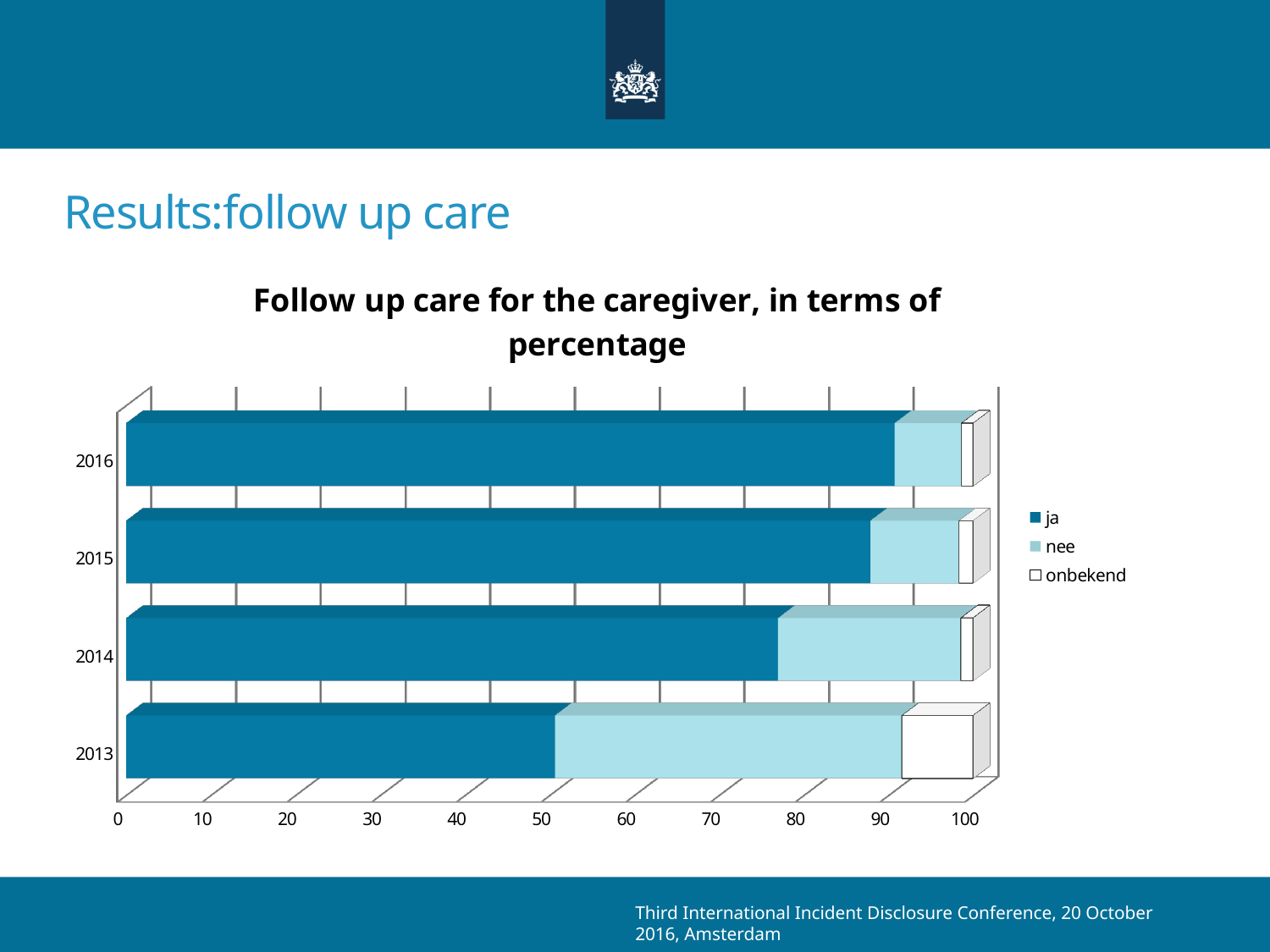
Is the 'ja' value for 2013 greater or less than 60? less How many years are shown on the chart? 4 Which year has the largest 'ja' segment? 2016 Is the 'ja' value for 2015 greater or less than 80? greater Is the 'ja' value for 2014 greater or less than 70? greater Does the 'ja' share rise or fall from 2013 to 2016? rise How many series does the legend list? 3 Which year has the largest 'nee' segment? 2013 What is the title of the chart? Follow up care for the caregiver, in terms of percentage What kind of chart is shown on the slide? bar chart Which is larger, the 'ja' value for 2014 or for 2015? 2015 Which year has the smallest 'ja' segment? 2013